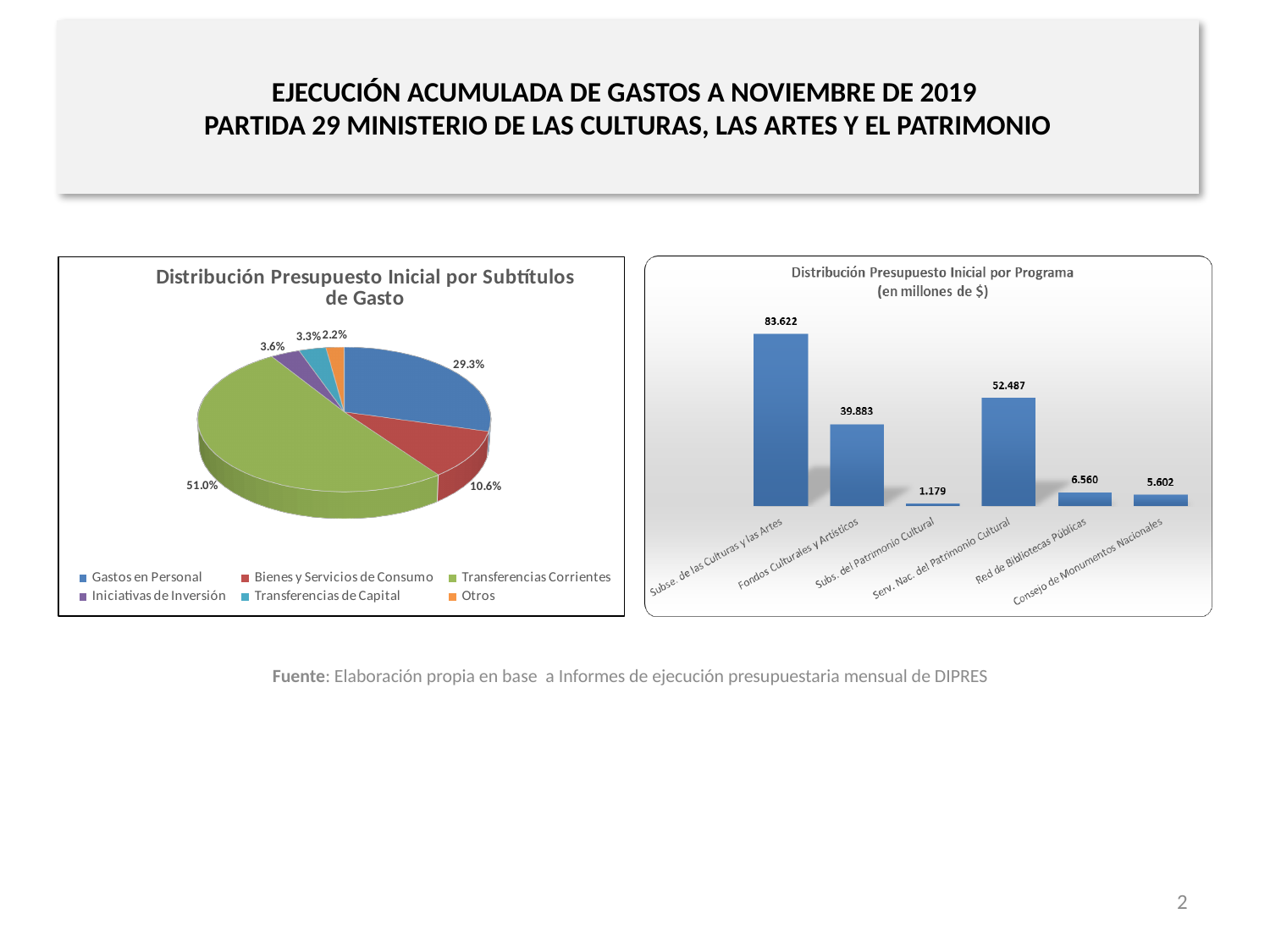
In the bar chart 'Distribución Presupuesto Inicial por Programa', which program has the lowest value? Subs. del Patrimonio Cultural In the bar chart 'Distribución Presupuesto Inicial por Programa', what is the value for Subse. de las Culturas y las Artes? 83.622 In the pie chart 'Distribución Presupuesto Inicial por Subtítulos de Gasto', what share does Transferencias Corrientes have? 51.0% In the bar chart 'Distribución Presupuesto Inicial por Programa', which is larger: Red de Bibliotecas Públicas or Consejo de Monumentos Nacionales? Red de Bibliotecas Públicas How many categories does the legend of the pie chart 'Distribución Presupuesto Inicial por Subtítulos de Gasto' list? 6 What kind of chart is 'Distribución Presupuesto Inicial por Programa'? Bar chart In the pie chart 'Distribución Presupuesto Inicial por Subtítulos de Gasto', what share does Bienes y Servicios de Consumo have? 10.6% In the pie chart 'Distribución Presupuesto Inicial por Subtítulos de Gasto', which category has the smallest share? Otros In the bar chart 'Distribución Presupuesto Inicial por Programa', what is the value for Serv. Nac. del Patrimonio Cultural? 52.487 In the bar chart 'Distribución Presupuesto Inicial por Programa', what is the difference between Subse. de las Culturas y las Artes and Serv. Nac. del Patrimonio Cultural? 31.135 In the pie chart 'Distribución Presupuesto Inicial por Subtítulos de Gasto', what share does Gastos en Personal have? 29.3% How many programs are shown in the bar chart 'Distribución Presupuesto Inicial por Programa'? 6